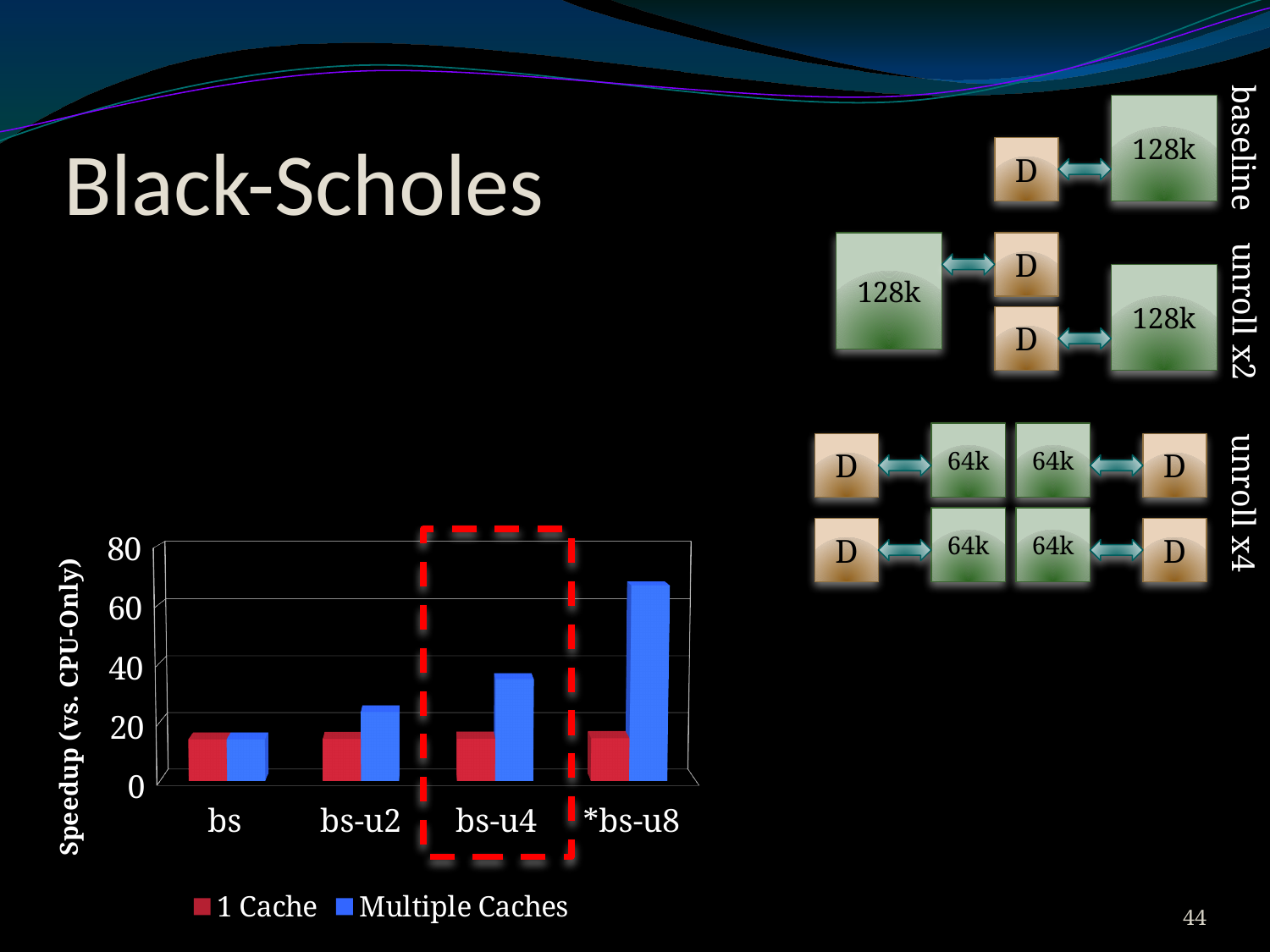
How many categories are shown on the x axis of the chart? 4 Is the Multiple Caches value for bs-u4 greater or less than 20? greater Is the 1 Cache value for bs-u4 greater or less than 20? less Which category has the lowest Multiple Caches value? bs Is the Multiple Caches value for bs-u2 greater or less than 40? less Which category has the highest Multiple Caches value? *bs-u8 What is the label of the chart's vertical axis? Speedup (vs. CPU-Only) Do the Multiple Caches values rise or fall from bs to *bs-u8? rise How many series does the chart's legend list? 2 For bs-u4, which is larger: the 1 Cache value or the Multiple Caches value? Multiple Caches What kind of chart is shown on the slide? bar chart